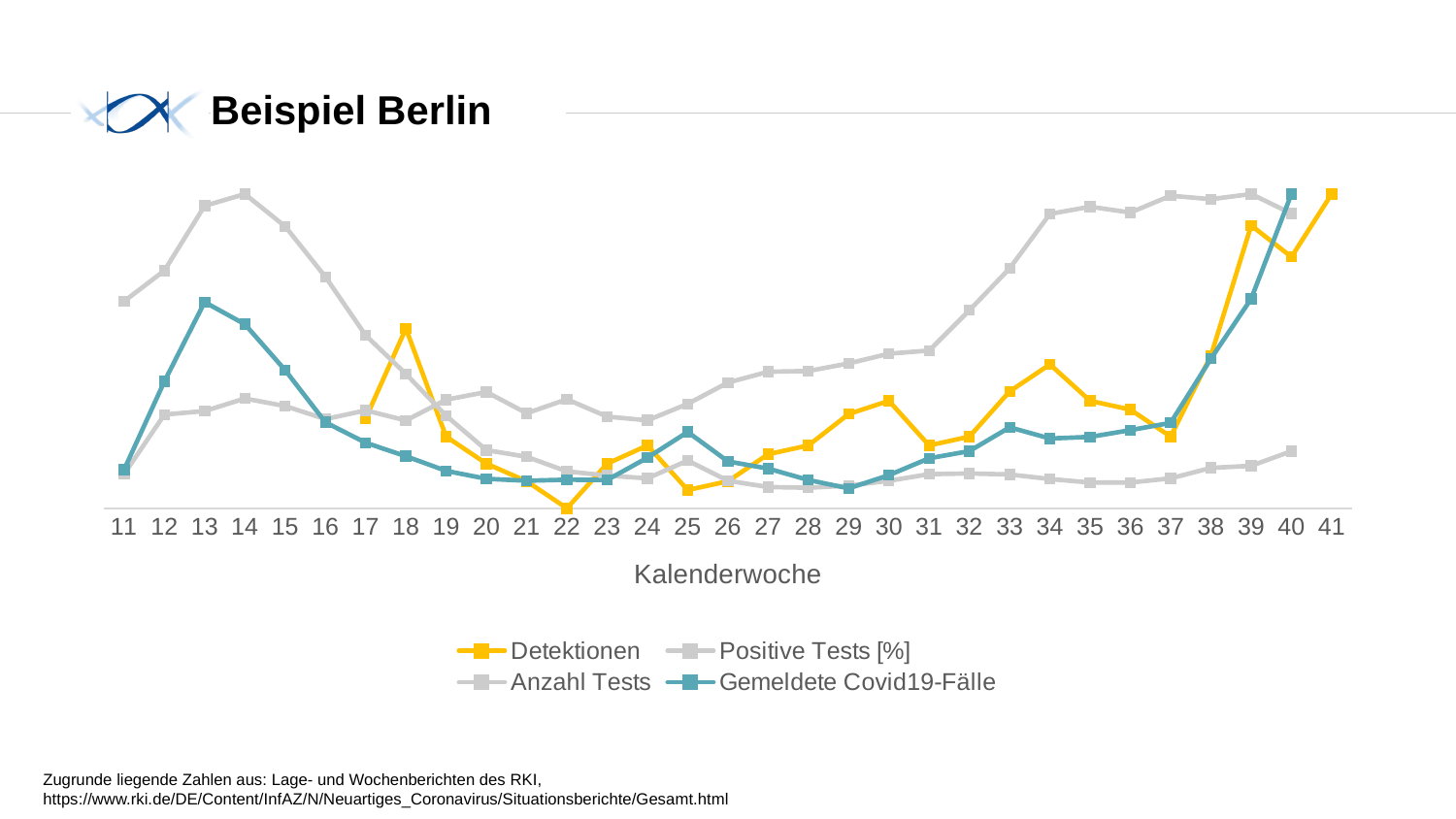
Does the Detektionen series rise or fall from calendar week 37 to week 41? Rise In which calendar week does the Gemeldete Covid19-Fälle series reach its highest value? 40 What kind of chart is shown on the slide? Line chart How many series does the legend list? 4 Does the Gemeldete Covid19-Fälle series rise or fall from calendar week 13 to week 21? Fall In calendar week 18, which is higher: Detektionen or Gemeldete Covid19-Fälle? Detektionen In which calendar week does the Detektionen series reach its highest value? 41 What is the label of the x axis? Kalenderwoche How many calendar weeks are shown on the x axis? 31 In which calendar week does the Detektionen series reach its lowest value? 22 What is the title of the slide? Beispiel Berlin